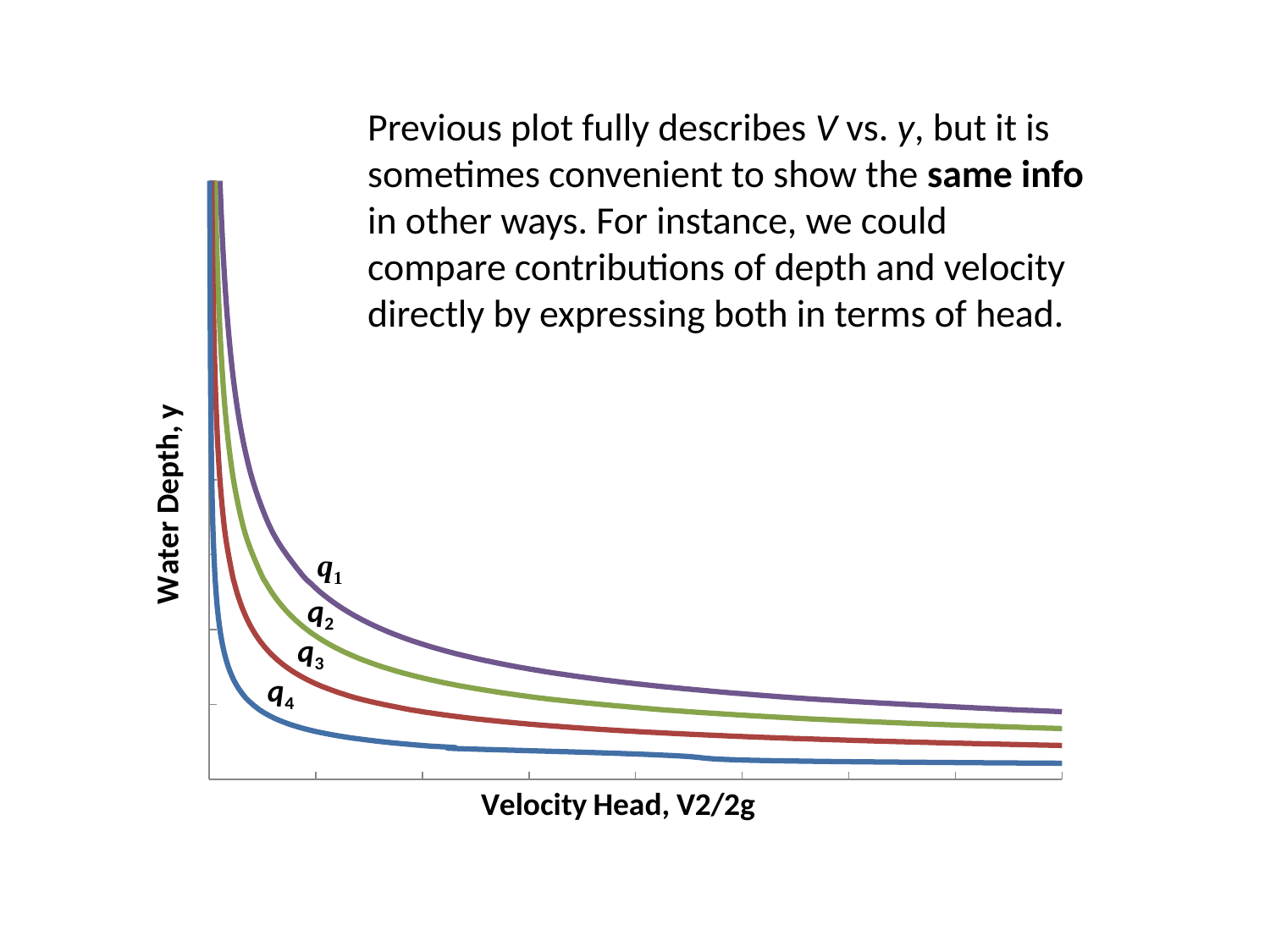
What kind of chart is shown on the slide? line chart What is the label of the x axis? Velocity Head, V2/2g Does water depth rise or fall as velocity head increases along the x axis? fall At the same velocity head, which curve shows the larger water depth, q2 or q3? q2 What is the label of the y axis? Water Depth, y Which curve lies lowest on the chart (smallest water depth at a given velocity head)? q4 Which curve lies highest on the chart (greatest water depth at a given velocity head)? q1 At the same velocity head, which curve shows the larger water depth, q4 or q1? q1 Which curve is labelled directly below q3 on the chart? q4 How many curves are plotted on the chart? 4